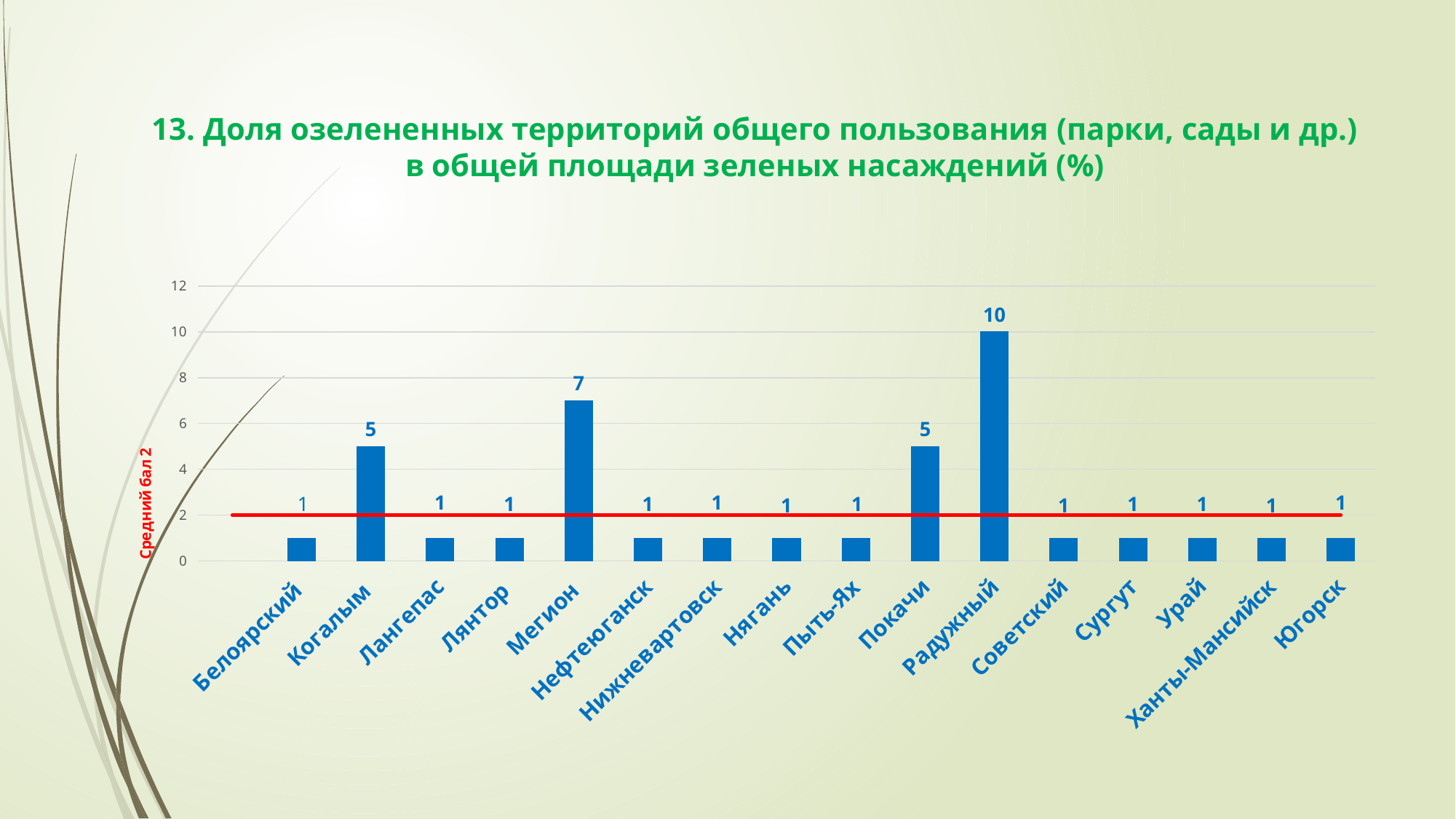
What is the value for Мегион? 7 What is the value for Ханты-Мансийск? 1 What is the value for Когалым? 5 Which is larger, the value for Мегион or the value for Покачи? Мегион What is the difference between the values for Радужный and Мегион? 3 What is the value for Радужный? 10 What value does the red horizontal line labelled 'Средний бал' mark? 2 Is the value for Радужный greater or less than 8? greater How many categories are shown on the x axis? 16 Which category has the highest value? Радужный What kind of chart is shown on the slide? bar chart What is the difference between the values for Покачи and Сургут? 4